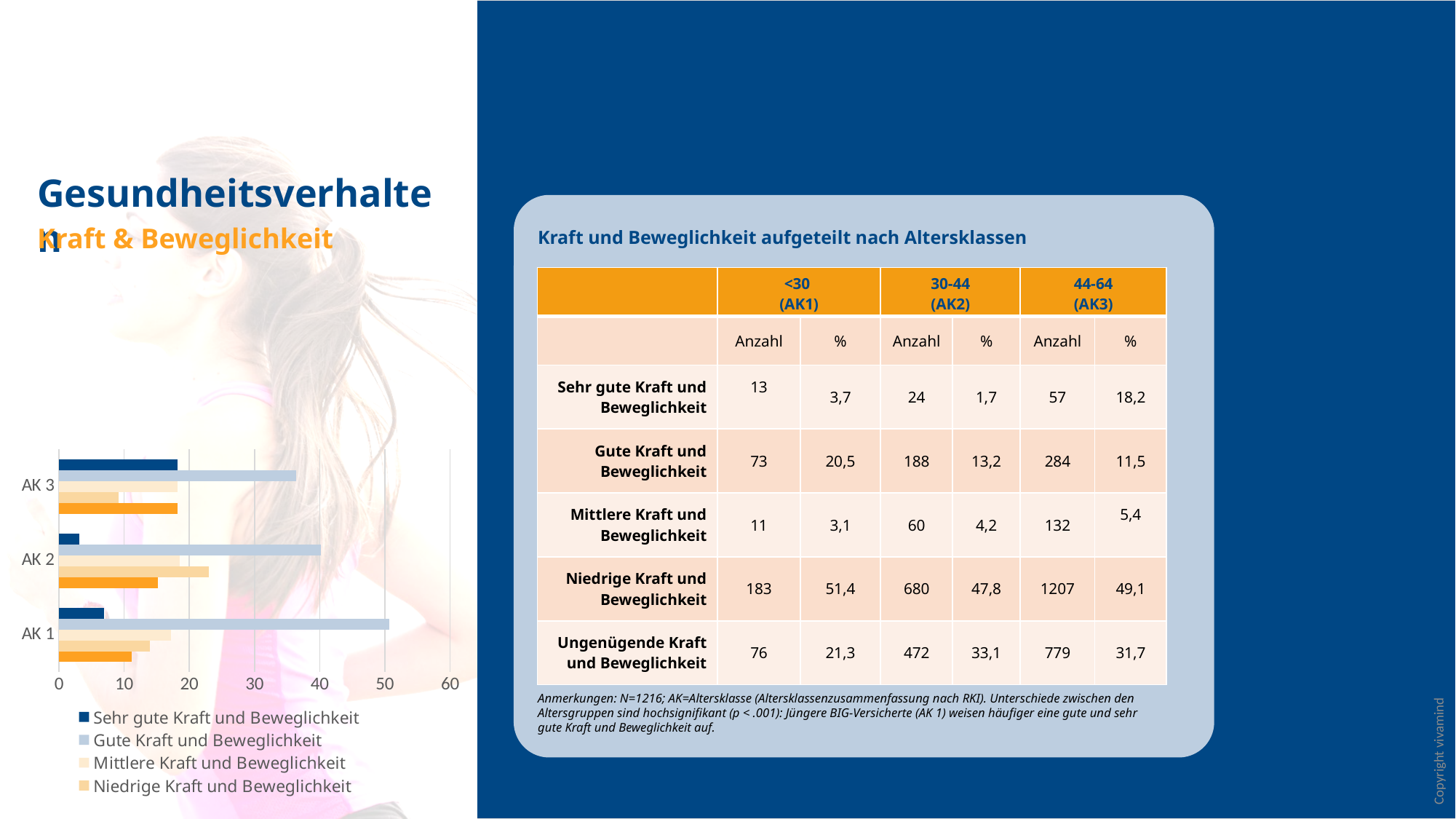
In the bar chart, is the 'Sehr gute Kraft und Beweglichkeit' bar for AK 1 greater or less than 10? less In the bar chart, is the 'Gute Kraft und Beweglichkeit' bar for AK 2 greater or less than 30? greater In the bar chart, is the 'Gute Kraft und Beweglichkeit' bar for AK 3 greater or less than 30? greater How many age-class categories (AK) are shown on the bar chart? 3 What kind of chart is shown on the left of the slide? bar chart In the bar chart, which is larger: the 'Gute Kraft und Beweglichkeit' bar for AK 1 or for AK 3? AK 1 What colour represents 'Sehr gute Kraft und Beweglichkeit' in the bar chart legend? dark blue In the bar chart, which category has the longest bar for 'Gute Kraft und Beweglichkeit'? AK 1 In the bar chart, which category has the shortest bar for 'Sehr gute Kraft und Beweglichkeit'? AK 2 In the bar chart, which is larger: the 'Sehr gute Kraft und Beweglichkeit' bar for AK 3 or for AK 2? AK 3